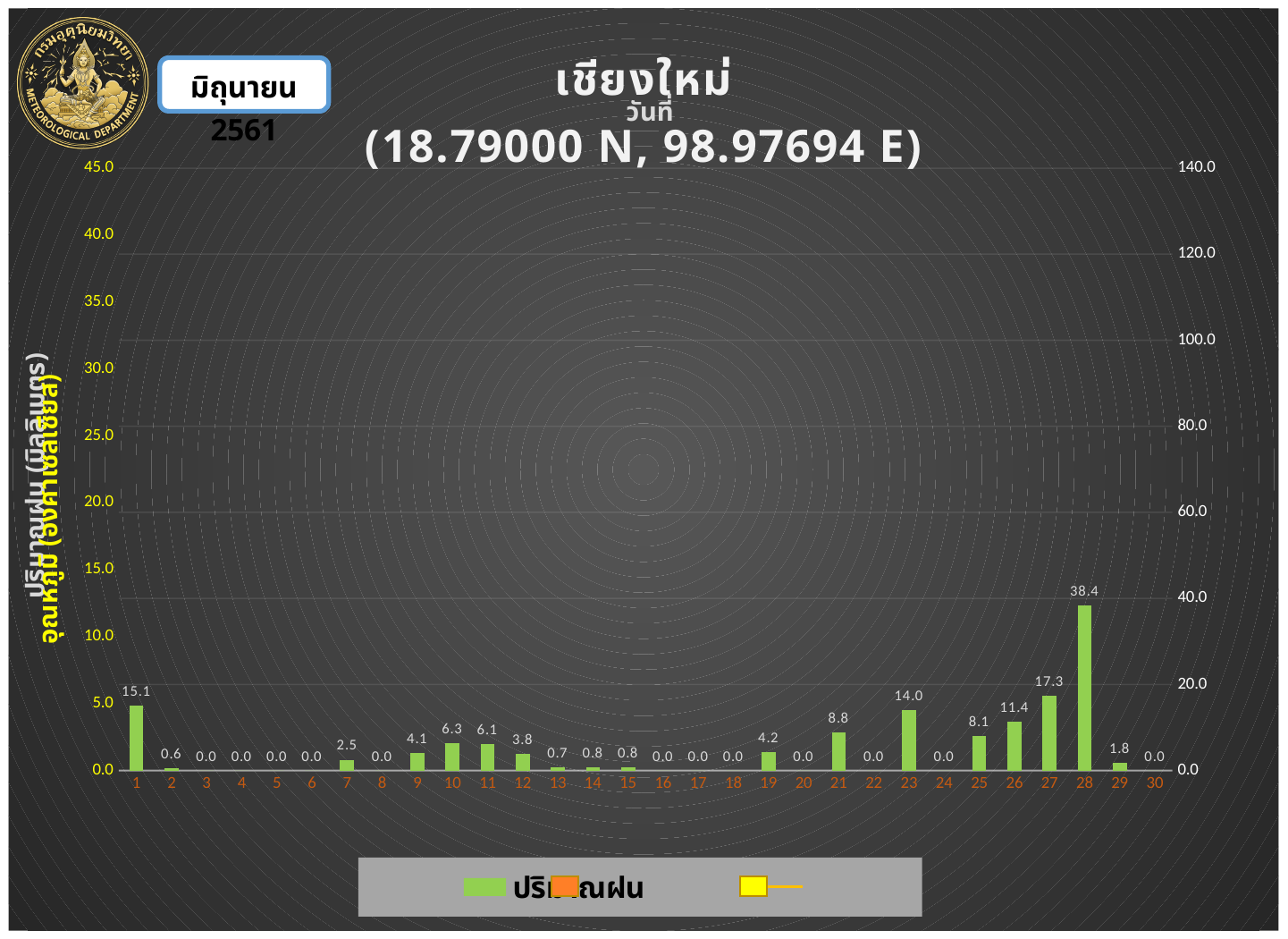
What is the rainfall value shown for day 1? 15.1 What is the rainfall value shown for day 28? 38.4 Do the rainfall values rise or fall from day 25 to day 28? rise Which has a larger rainfall value, day 9 or day 19? day 19 Which day has the highest rainfall value in the chart? 28 What is the rainfall value shown for day 23? 14.0 What is the difference between the rainfall values for day 28 and day 27? 21.1 What is the difference between the rainfall values for day 1 and day 23? 1.1 Which has a larger rainfall value, day 21 or day 26? day 26 What is the rainfall value shown for day 10? 6.3 How many days are shown on the x axis of the chart? 30 What kind of chart is used to show the rainfall values? bar chart